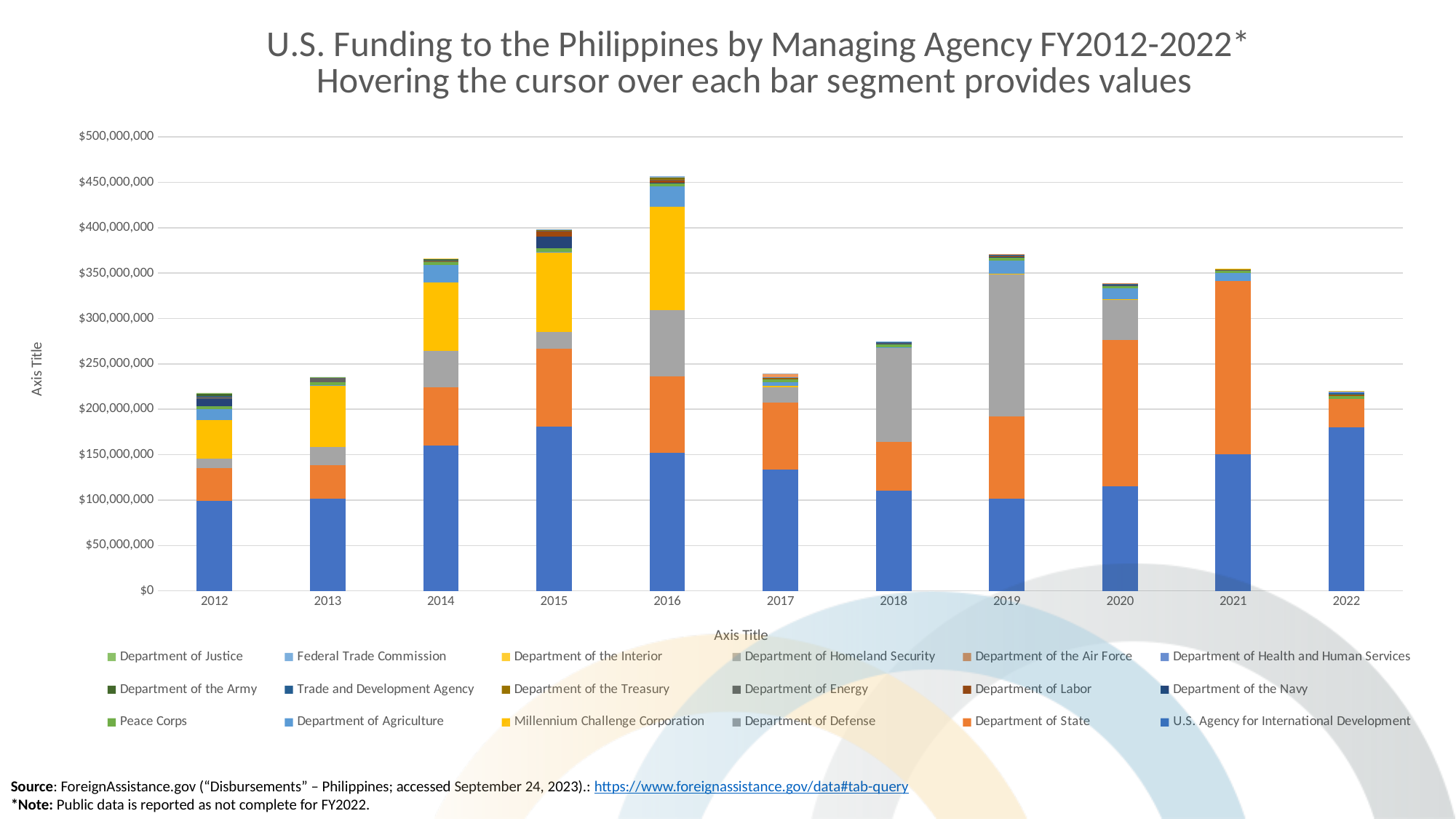
What kind of chart is shown on the slide? Stacked bar chart Which year has the larger total funding bar, 2016 or 2015? 2016 Is the total funding bar for 2017 greater or less than $250,000,000? less Is the total funding bar for 2012 greater or less than $250,000,000? less Is the U.S. Agency for International Development segment for 2022 greater or less than $150,000,000? greater Which year has the larger total funding bar, 2019 or 2018? 2019 What is the title of the chart? U.S. Funding to the Philippines by Managing Agency FY2012-2022* Hovering the cursor over each bar segment provides values Which fiscal year has the highest total funding bar? 2016 How many fiscal years (categories) are plotted along the x axis? 11 How many managing agencies (series) does the legend list? 18